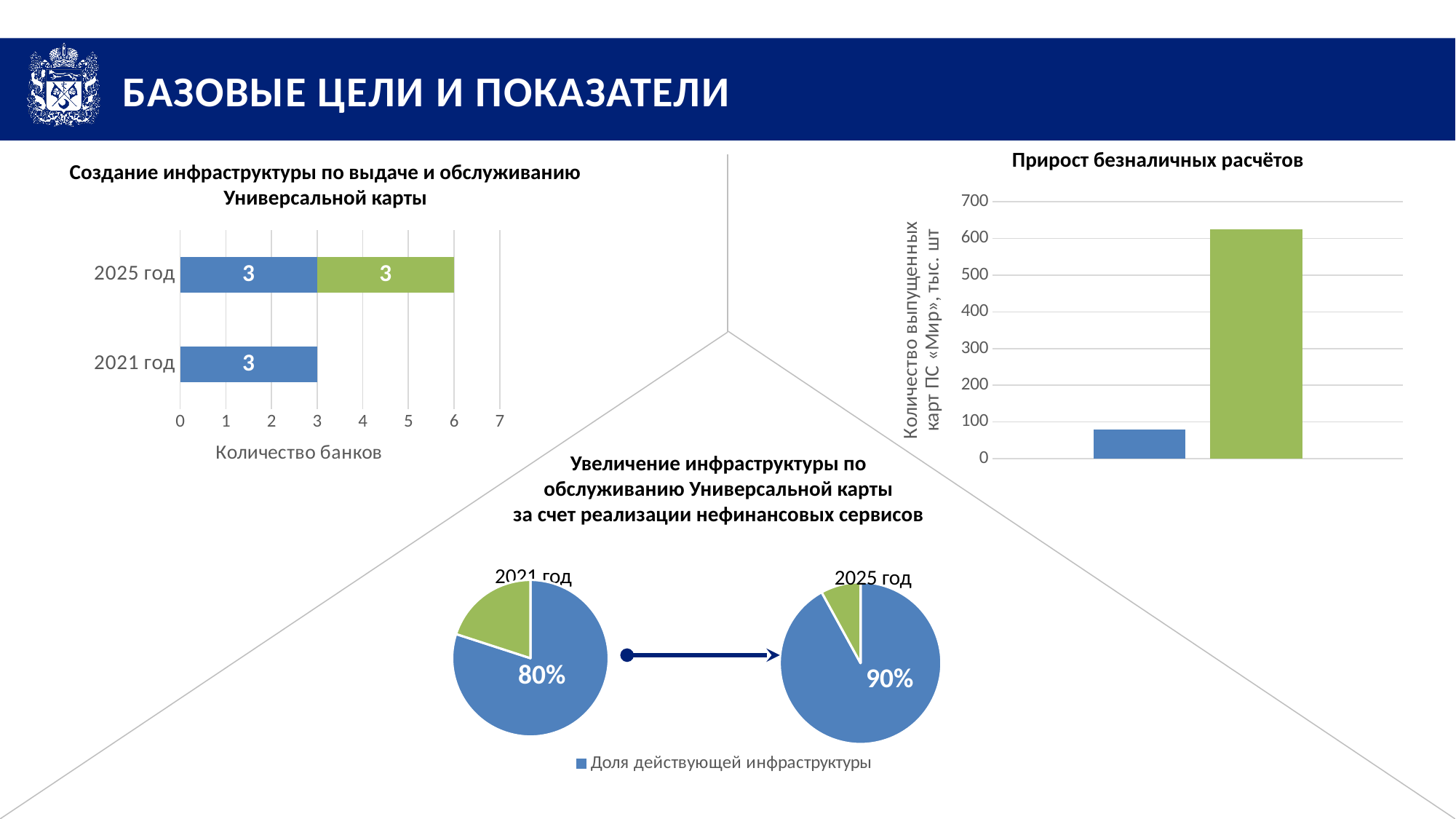
In the bottom pie charts «Увеличение инфраструктуры по обслуживанию Универсальной карты за счет реализации нефинансовых сервисов», what share does the blue slice have in the 2025 год pie? 90% What kind of chart is the top-left chart titled «Создание инфраструктуры по выдаче и обслуживанию Универсальной карты»? bar chart What kind of chart is the top-right chart titled «Прирост безналичных расчётов»? bar chart In the top-right chart «Прирост безналичных расчётов», is the value of the blue bar greater or less than 100? less In the top-left chart «Создание инфраструктуры по выдаче и обслуживанию Универсальной карты», what is the value for 2021 год? 3 In the top-right chart «Прирост безналичных расчётов», which bar is larger, the blue bar or the green bar? the green bar In the top-right chart «Прирост безналичных расчётов», how many bars are plotted? 2 In the bottom pie charts «Увеличение инфраструктуры по обслуживанию Универсальной карты за счет реализации нефинансовых сервисов», what share does the blue slice have in the 2021 год pie? 80% In the top-right chart «Прирост безналичных расчётов», is the value of the green bar greater or less than 500? greater In the top-left chart «Создание инфраструктуры по выдаче и обслуживанию Универсальной карты», how many year categories are shown? 2 In the top-left chart «Создание инфраструктуры по выдаче и обслуживанию Универсальной карты», what is the total of the stacked bar for 2025 год? 6 In the top-left chart «Создание инфраструктуры по выдаче и обслуживанию Универсальной карты», what is the x-axis title? Количество банков